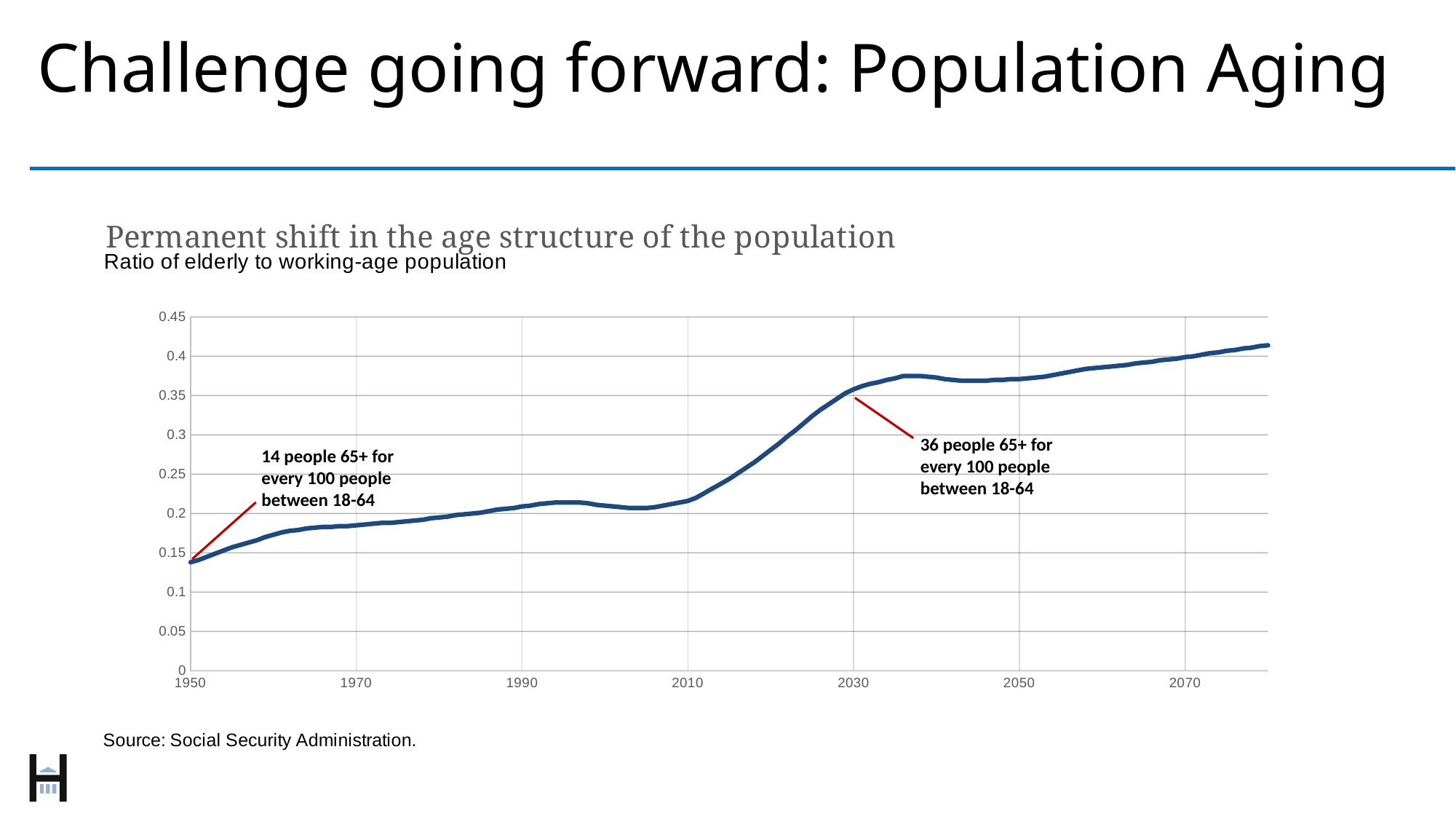
Is the value for 2070 greater or less than 0.35? greater Does the ratio of elderly to working-age population generally rise or fall from 1950 to 2080? rise Is the value for 1950 greater or less than 0.2? less Which year shown on the x axis has the lowest ratio? 1950 Is the value for 2010 greater or less than 0.25? less What is the title of the chart? Permanent shift in the age structure of the population According to the annotation, how many people 65+ are there for every 100 people between 18-64 in 1950? 14 What kind of chart is shown on the slide? line chart Which is larger, the value for 2030 or the value for 1990? 2030 How many year labels are shown on the x axis? 7